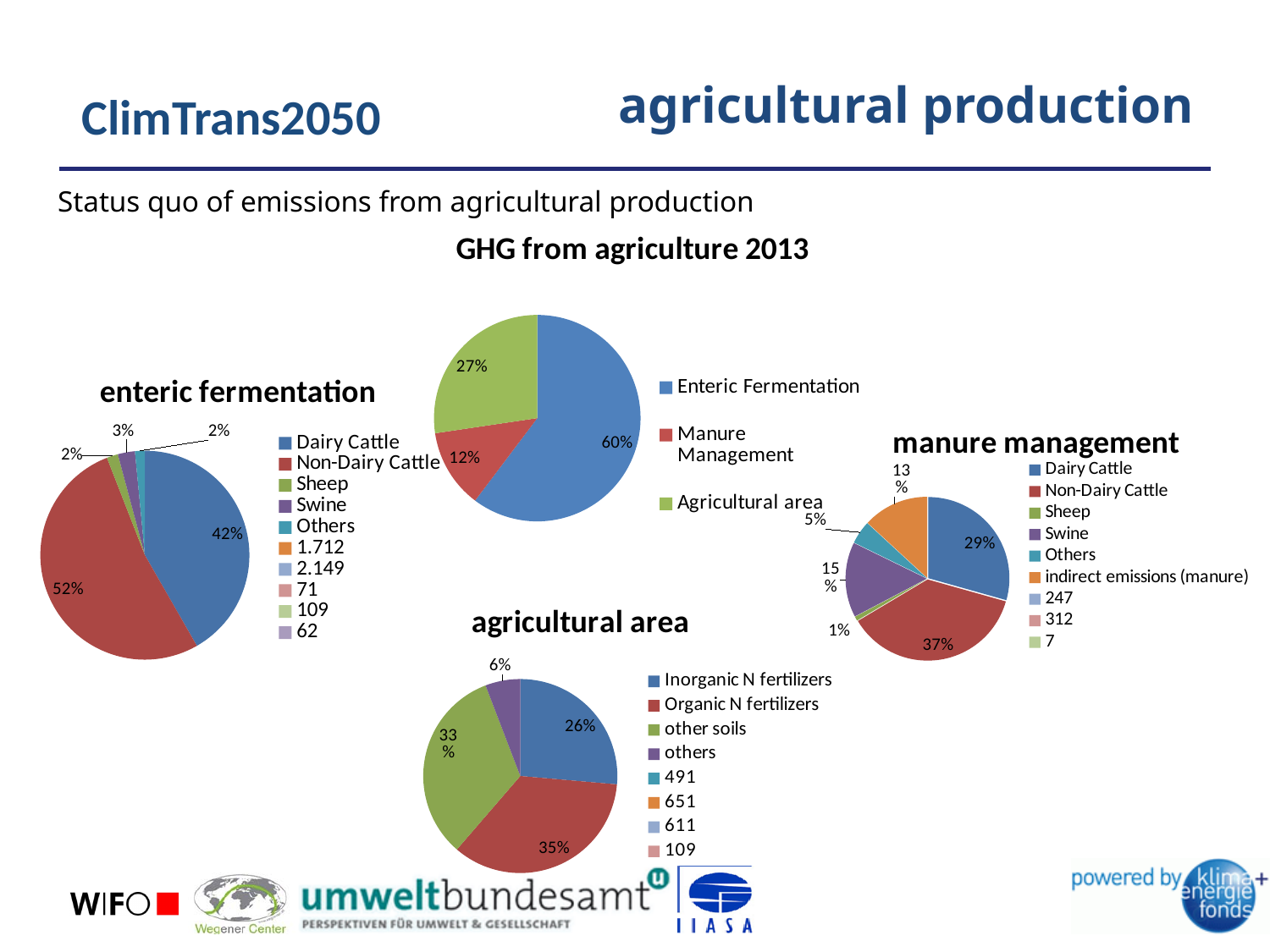
In the 'enteric fermentation' pie chart, what share is Non-Dairy Cattle? 52% In the 'agricultural area' pie chart, what share is Organic N fertilizers? 35% What type of chart is the 'agricultural area' chart? Pie chart In the 'enteric fermentation' pie chart, what share is Swine? 3% In the 'manure management' pie chart, what share is Non-Dairy Cattle? 37% In the 'enteric fermentation' pie chart, which is larger, Dairy Cattle or Non-Dairy Cattle? Non-Dairy Cattle In the 'manure management' pie chart, what share is indirect emissions (manure)? 13% In the 'GHG from agriculture 2013' pie chart, what is the difference between the Agricultural area share and the Manure Management share? 15% In the 'agricultural area' pie chart, what is the difference between the other soils share and the Inorganic N fertilizers share? 7% In the 'manure management' pie chart, which category has the smallest share? Sheep In the 'GHG from agriculture 2013' pie chart, what share is Enteric Fermentation? 60% In the 'GHG from agriculture 2013' pie chart, which category has the smallest share? Manure Management